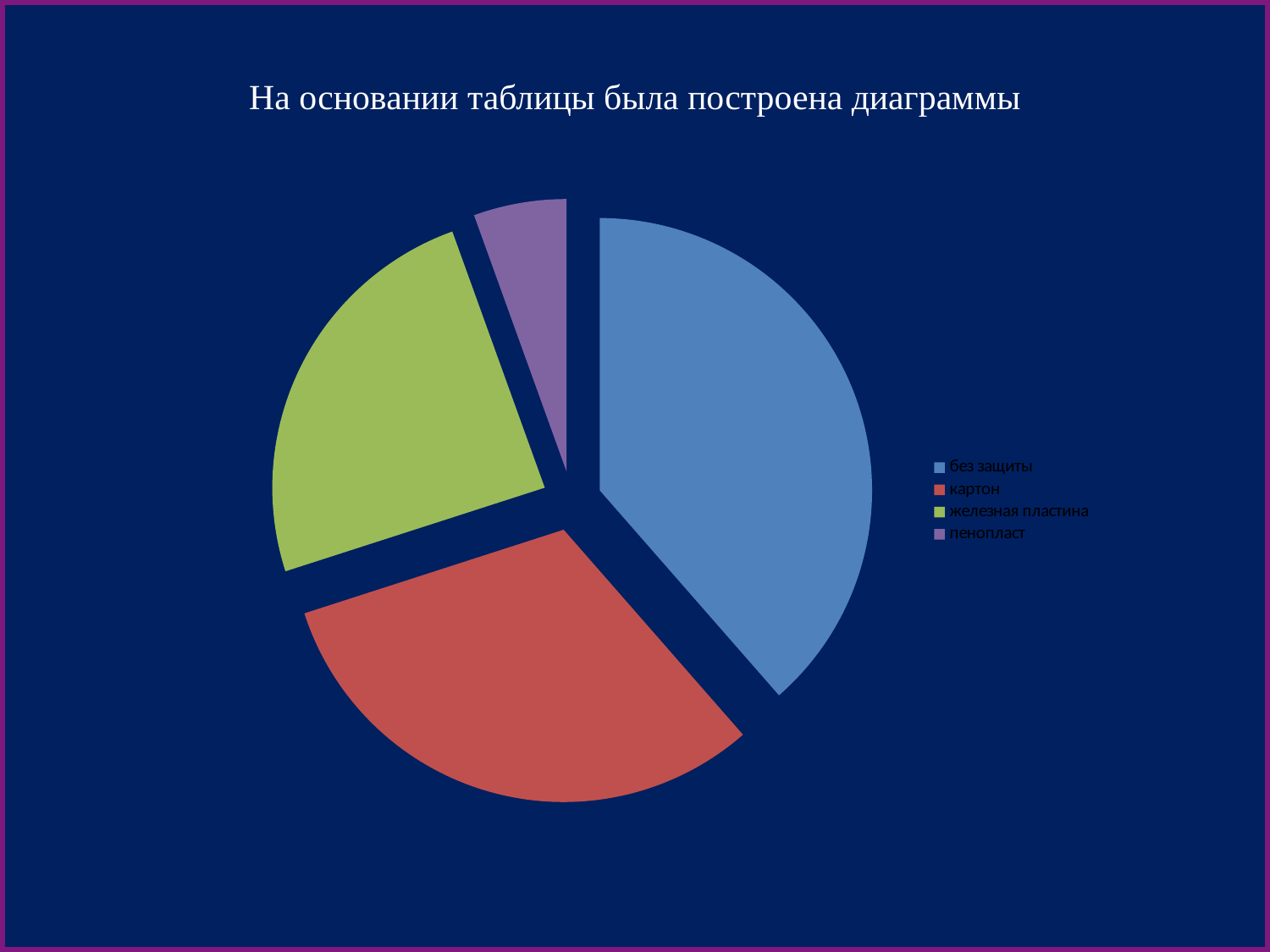
Which category has the smallest slice of the pie chart? пенопласт How many slices does the pie chart have? 4 How many entries does the legend of the pie chart list? 4 Which slice is larger, без защиты or картон? без защиты What colour is the slice for железная пластина in the pie chart? green Which category has the largest slice of the pie chart? без защиты Which slice is larger, железная пластина or пенопласт? железная пластина Which category is shown in red in the pie chart? картон Which slice is larger, картон or пенопласт? картон What kind of chart is shown on the slide? pie chart